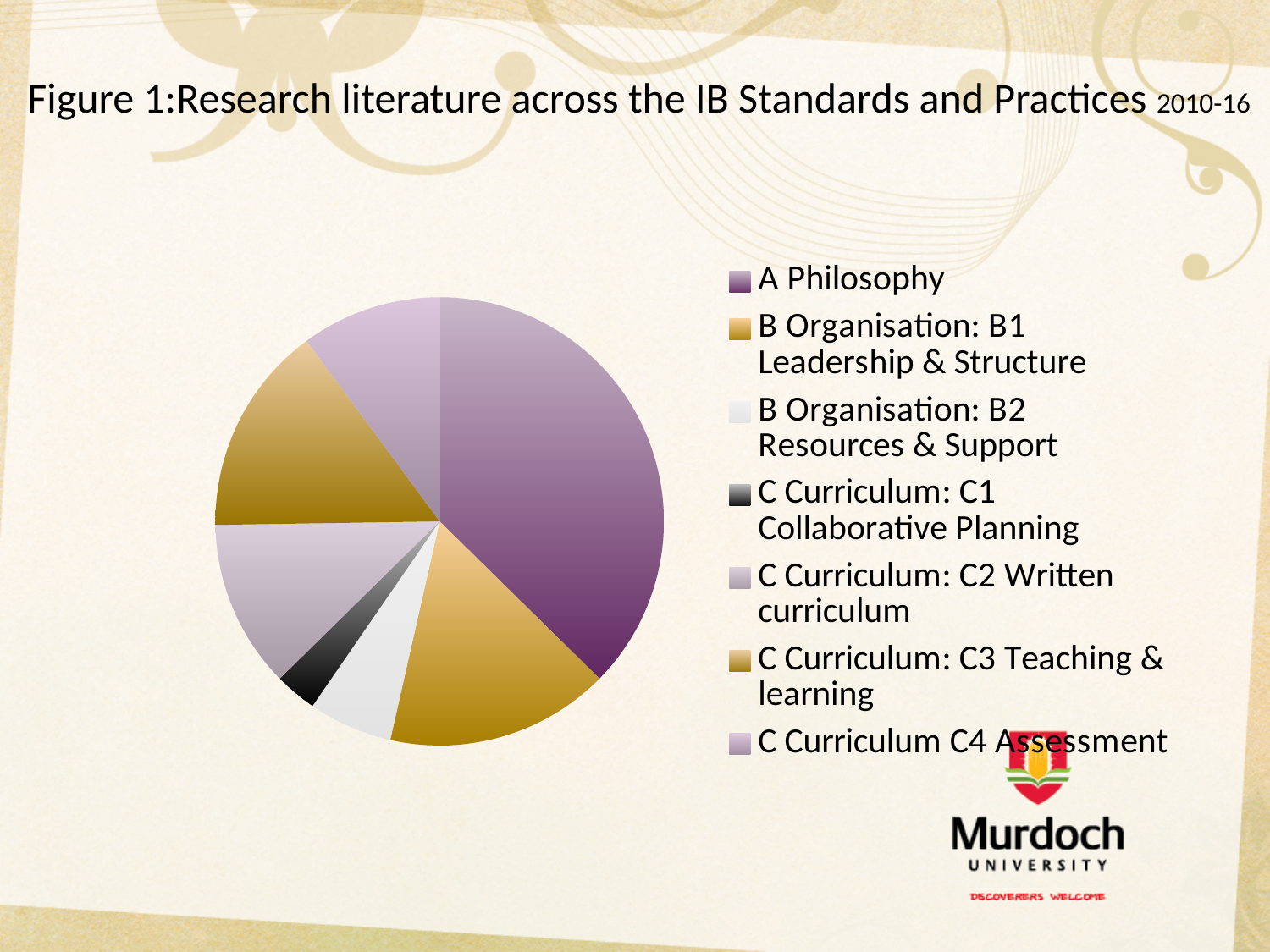
What colour is the slice for C Curriculum: C1 Collaborative Planning? black What kind of chart is shown on the slide? pie chart What is the title of the chart on the slide? Figure 1:Research literature across the IB Standards and Practices 2010-16 Which category has the smallest slice of the pie? C Curriculum: C1 Collaborative Planning Which slice is larger, C Curriculum: C1 Collaborative Planning or B Organisation: B2 Resources & Support? B Organisation: B2 Resources & Support How many entries does the legend list? 7 Which category has the largest slice of the pie? A Philosophy How many slices does the pie chart have? 7 Which slice is larger, C Curriculum: C3 Teaching & learning or C Curriculum: C2 Written curriculum? C Curriculum: C3 Teaching & learning Which slice is larger, A Philosophy or B Organisation: B1 Leadership & Structure? A Philosophy